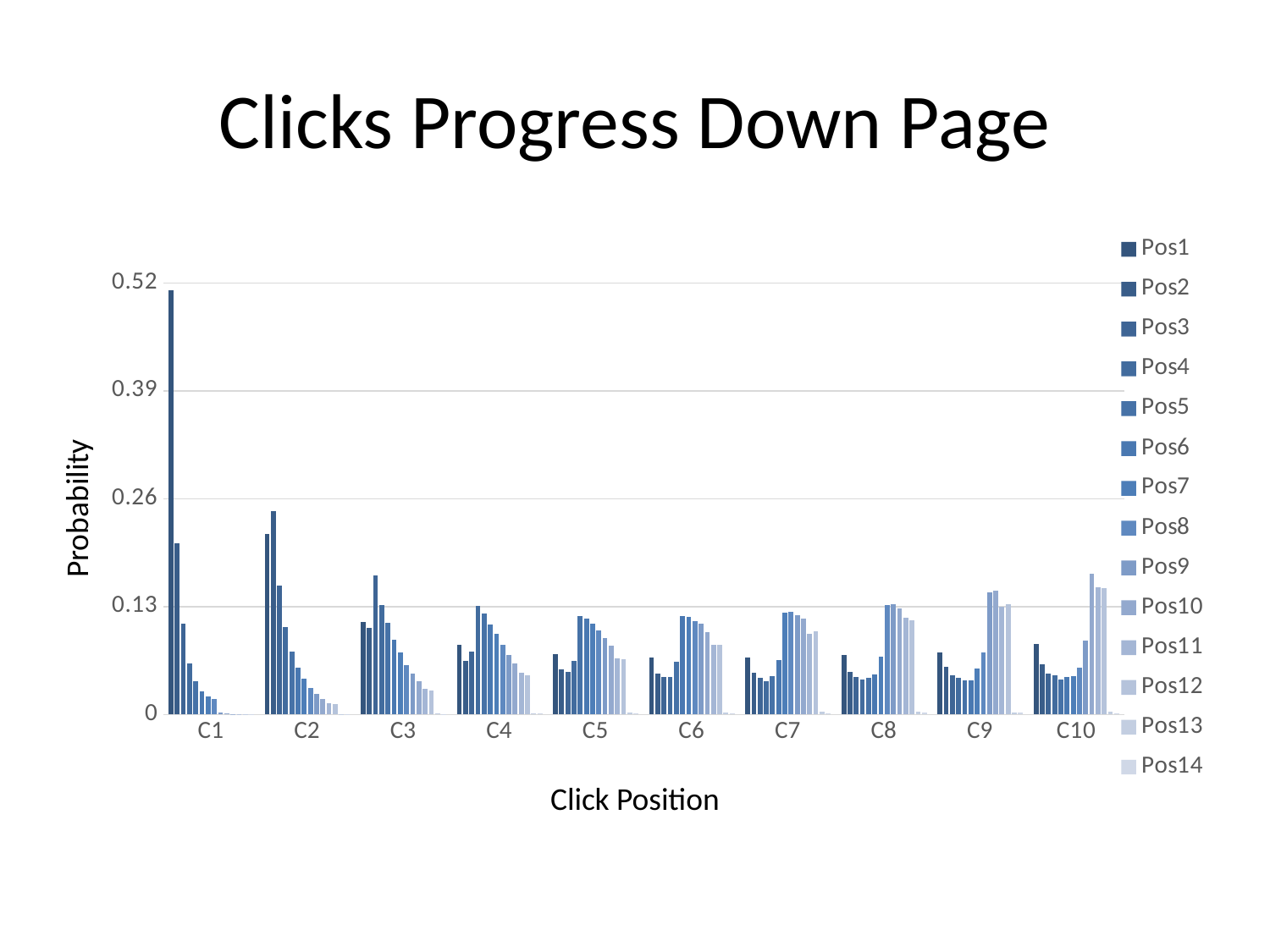
Which series has the highest value at C2? Pos2 Which is larger: Pos1 at C1 or Pos1 at C2? Pos1 at C1 Is the value for Pos1 at C1 greater or less than 0.39? greater What is the title of the chart? Clicks Progress Down Page What kind of chart is shown on the slide? bar chart Which series has the highest value at C1? Pos1 How many click position categories are shown on the x axis? 10 Is the value for Pos1 at C10 greater or less than 0.13? less What is the label of the y axis? Probability How many series does the legend list? 14 Is the value for Pos1 at C2 greater or less than 0.26? less